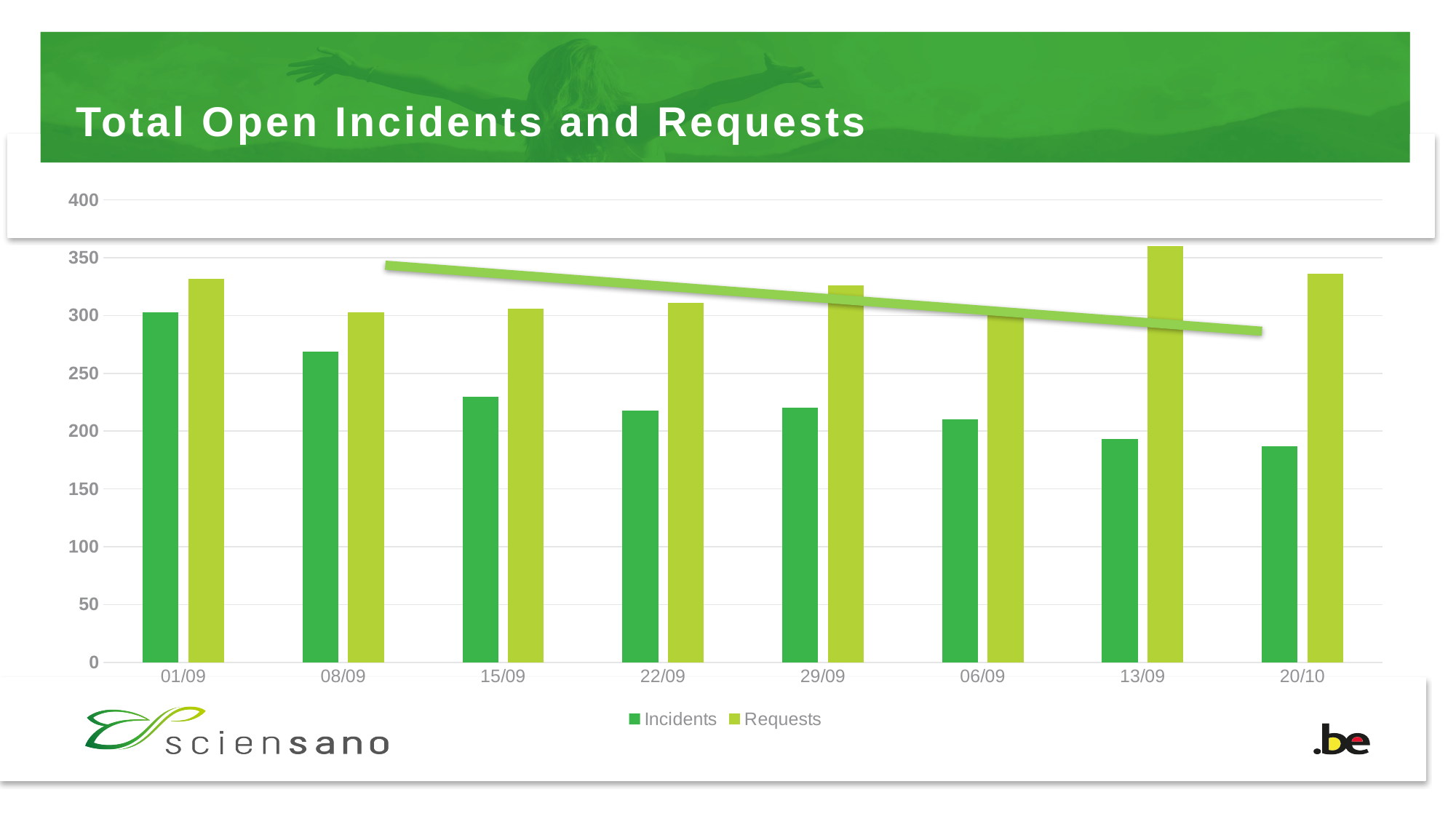
How many dates are shown on the x axis? 8 Is the value for Incidents on 15/09 greater or less than 250? less On 13/09, which is larger, Incidents or Requests? Requests Do the Incidents values generally rise or fall from 01/09 to 20/10? fall How many series does the legend list? 2 Is the value for Incidents on 20/10 greater or less than 200? less On which date is the Incidents bar highest? 01/09 Is the value for Incidents on 08/09 greater or less than 250? greater On which date is the Requests bar highest? 13/09 What is the title of the chart? Total Open Incidents and Requests What kind of chart is shown on the slide? bar chart